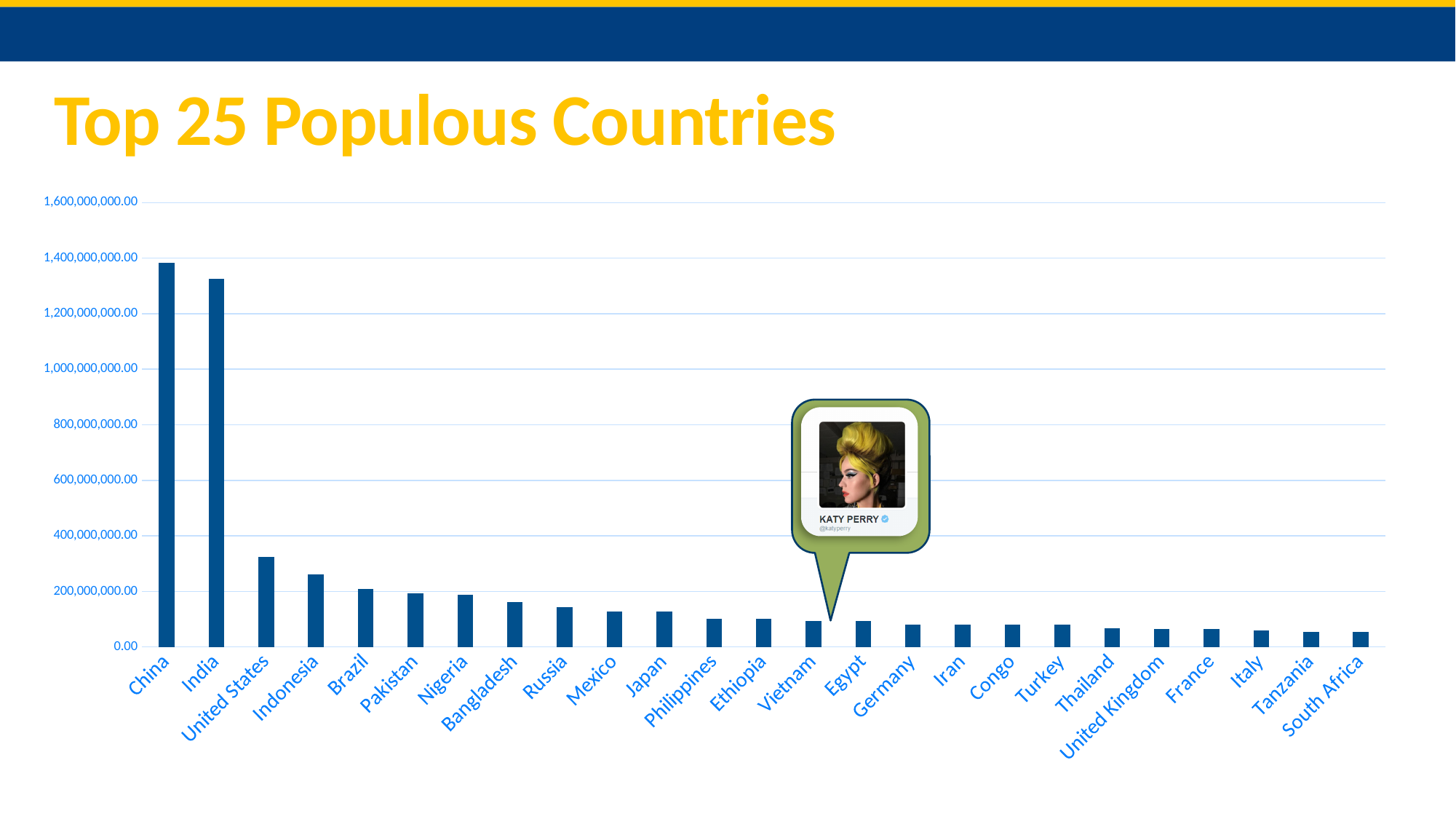
What is the title of the slide containing the chart? Top 25 Populous Countries How many countries are plotted on the chart? 25 Is the value for India greater or less than 1,200,000,000.00? greater Is the value for China greater or less than 1,200,000,000.00? greater Is the value for Bangladesh greater or less than 200,000,000.00? less Which country has the highest population on the chart? China Which is larger, the value for United States or the value for Indonesia? United States What kind of chart is shown on the slide? bar chart Do the values rise or fall moving from left to right along the x axis? fall Which is larger, the value for China or the value for India? China